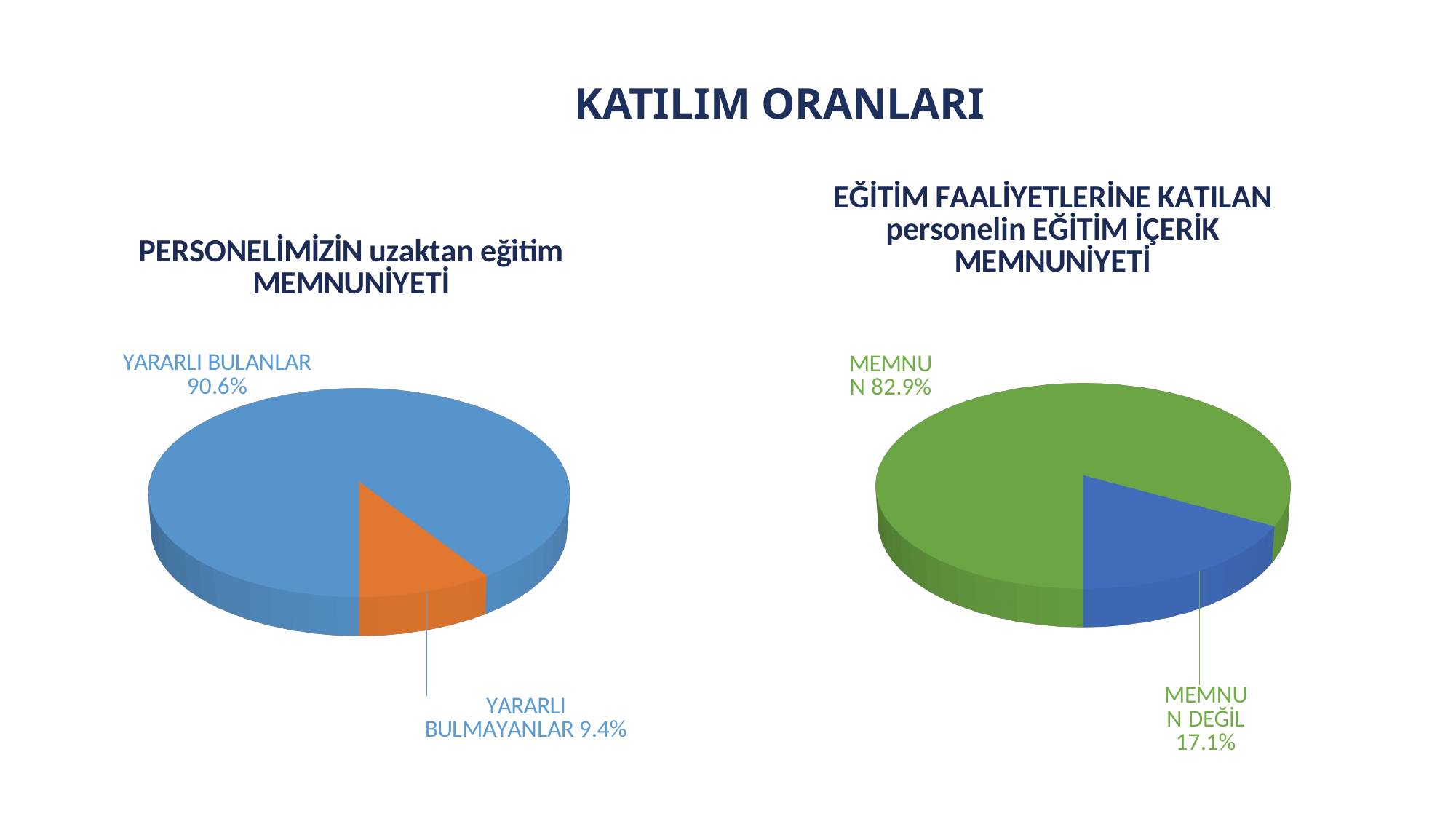
In the left chart (PERSONELİMİZİN uzaktan eğitim MEMNUNİYETİ), what is the difference in percentage points between YARARLI BULANLAR and YARARLI BULMAYANLAR? 81.2 In the right chart (EĞİTİM İÇERİK MEMNUNİYETİ), what share is labelled for MEMNUN? 82.9% In the right chart (EĞİTİM İÇERİK MEMNUNİYETİ), what is the difference in percentage points between MEMNUN and MEMNUN DEĞİL? 65.8 In the left chart (PERSONELİMİZİN uzaktan eğitim MEMNUNİYETİ), which slice is the largest? YARARLI BULANLAR Which is larger: the MEMNUN DEĞİL share in the right chart or the YARARLI BULMAYANLAR share in the left chart? MEMNUN DEĞİL What is the main title at the top of the slide? KATILIM ORANLARI In the left chart (PERSONELİMİZİN uzaktan eğitim MEMNUNİYETİ), what share is labelled for YARARLI BULMAYANLAR? 9.4% What kind of chart is the right chart (EĞİTİM İÇERİK MEMNUNİYETİ)? Pie chart How many slices does the left chart (PERSONELİMİZİN uzaktan eğitim MEMNUNİYETİ) have? 2 In the left chart (PERSONELİMİZİN uzaktan eğitim MEMNUNİYETİ), what share is labelled for YARARLI BULANLAR? 90.6% In the right chart (EĞİTİM İÇERİK MEMNUNİYETİ), what share is labelled for MEMNUN DEĞİL? 17.1% In the right chart (EĞİTİM İÇERİK MEMNUNİYETİ), which slice is the smallest? MEMNUN DEĞİL